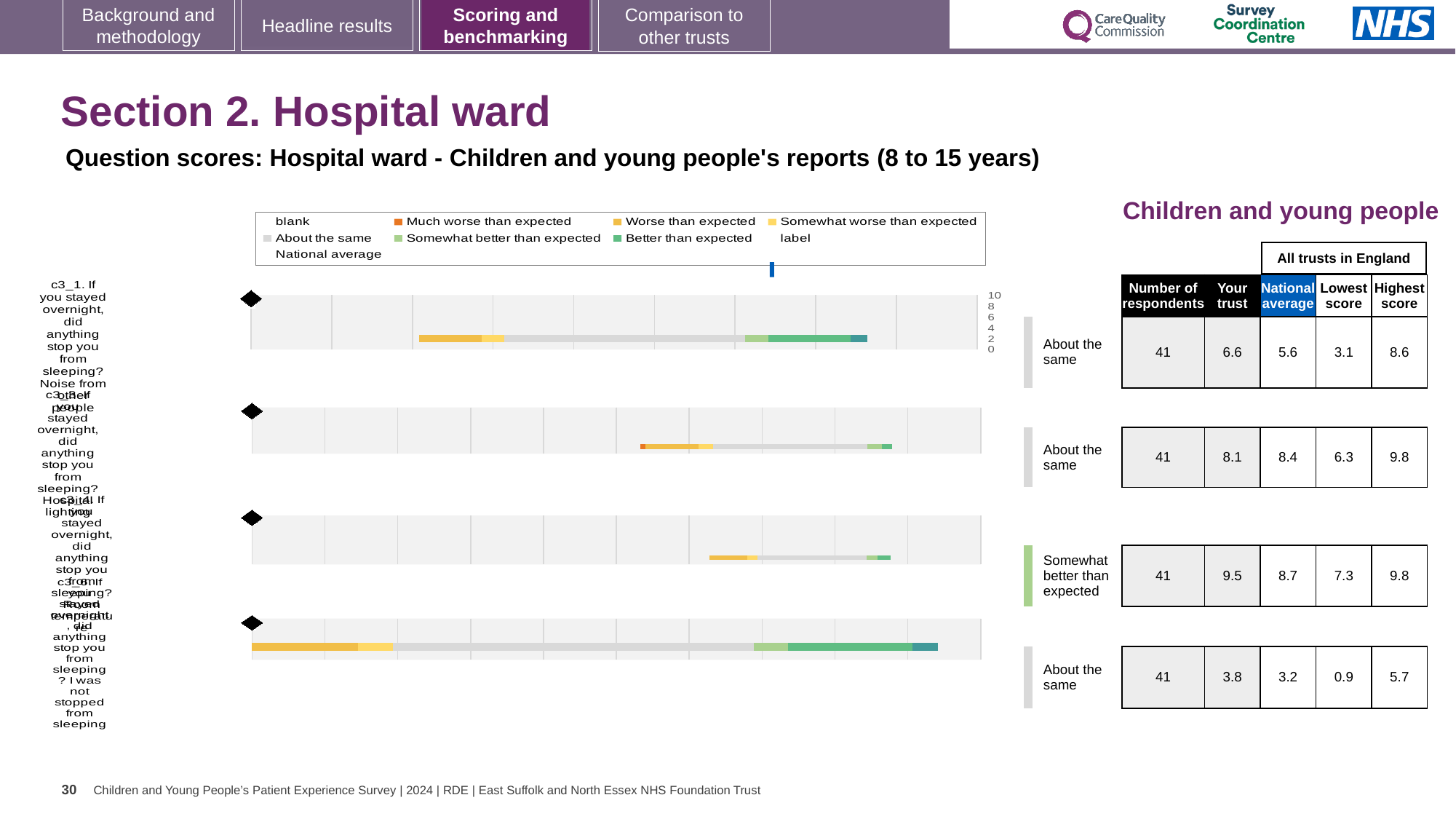
What is the difference between the 'Your trust' score and the national average for the third row (c3_4)? 0.8 What benchmark rating is shown for the third row (c3_4)? Somewhat better than expected In the table, what is the 'Your trust' score for the first row (c3_1)? 6.6 Which row has the highest 'Your trust' score? the third row (c3_4), 9.5 In the table, what is the national average for the second row (c3_3)? 8.4 For the third row (c3_4), which is larger: the 'Your trust' score or the national average? Your trust What kind of chart is used to show the question scores on this slide? bar chart How many respondents are listed for the first row (c3_1)? 41 Which row has the lowest 'Your trust' score? the fourth row (c3_6), 3.8 In the table, what is the 'Your trust' score for the third row (c3_4)? 9.5 How many questions (rows) are plotted in the chart? 4 In the table, what is the lowest score for the fourth row (c3_6)? 0.9